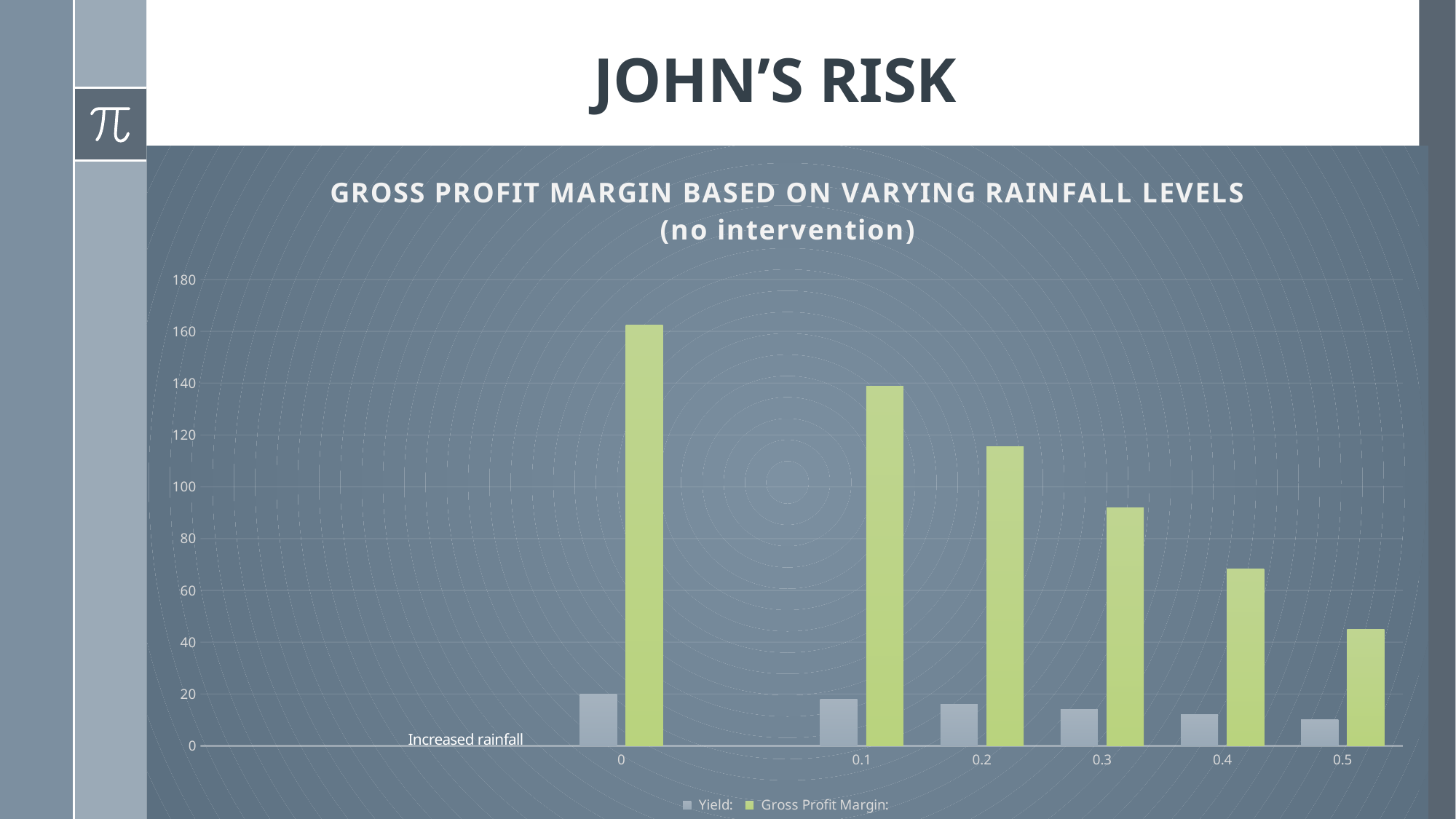
Is the Yield value at rainfall level 0 greater or less than 40? less What is the title of the chart? GROSS PROFIT MARGIN BASED ON VARYING RAINFALL LEVELS (no intervention) What kind of chart is shown on the slide? bar chart Which is larger, the Gross Profit Margin at rainfall level 0.1 or at rainfall level 0.4? 0.1 Do the Gross Profit Margin values rise or fall as rainfall level increases along the x axis? fall At which rainfall level is the Gross Profit Margin highest? 0 Is the Gross Profit Margin at rainfall level 0.5 greater or less than 40? greater Which series are listed in the legend? Yield and Gross Profit Margin Is the Gross Profit Margin at rainfall level 0 greater or less than 140? greater At which rainfall level is the Gross Profit Margin lowest? 0.5 How many series does the legend list? 2